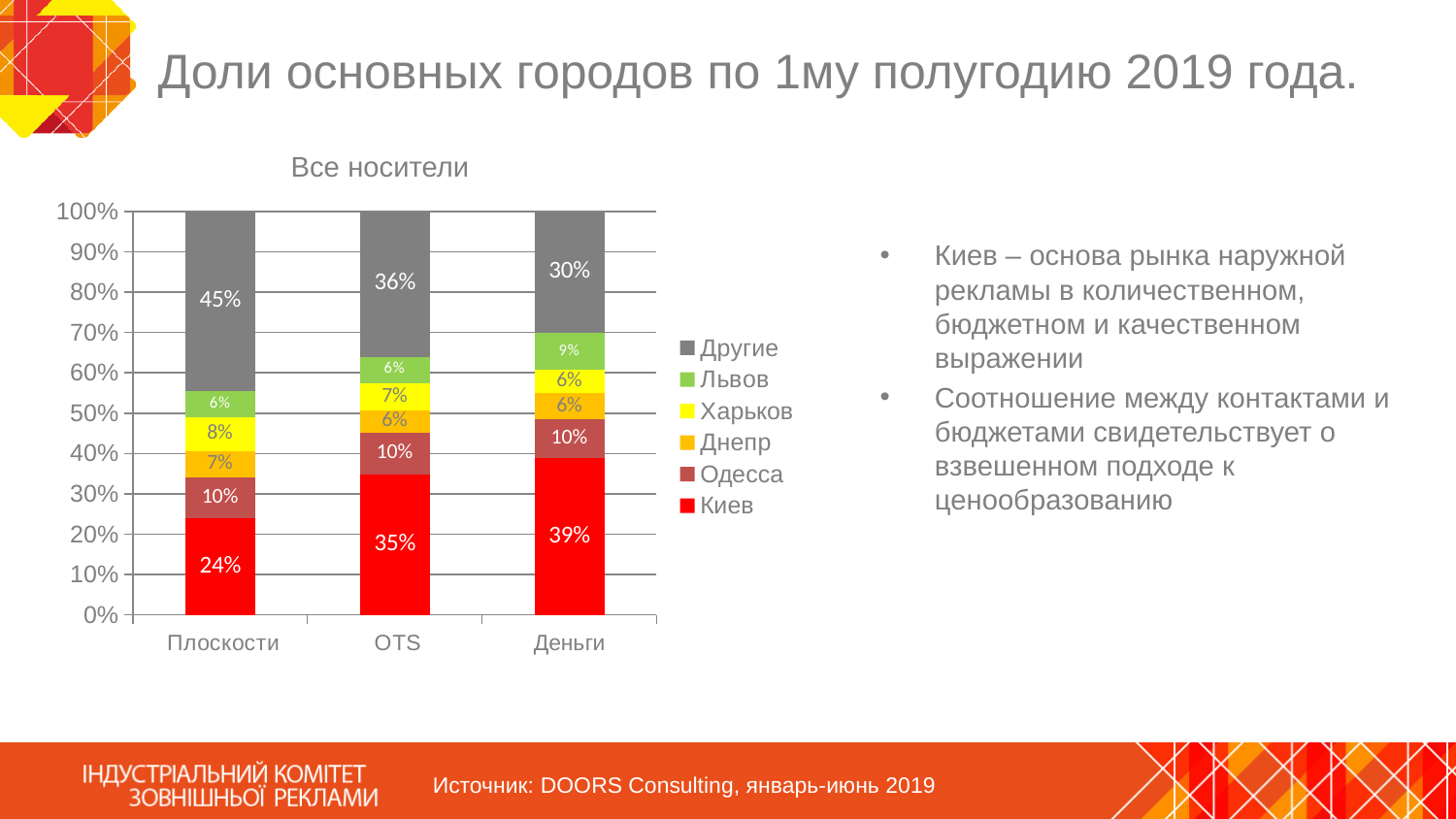
What is the value for Львов in the Деньги bar? 9% How many categories are shown on the x axis? 3 What kind of chart is shown on the slide? stacked bar chart In which category is the value for Киев the highest? Деньги What is the value for Другие in the OTS bar? 36% What is the title of the chart? Все носители Which is larger: the Другие value for Плоскости or the Другие value for Деньги? Плоскости How many series does the legend list? 6 What is the value for Киев in the Плоскости bar? 24% What is the value for Харьков in the Плоскости bar? 8% In which category is the value for Другие the lowest? Деньги What is the difference between the Киев values for Деньги and Плоскости? 15%